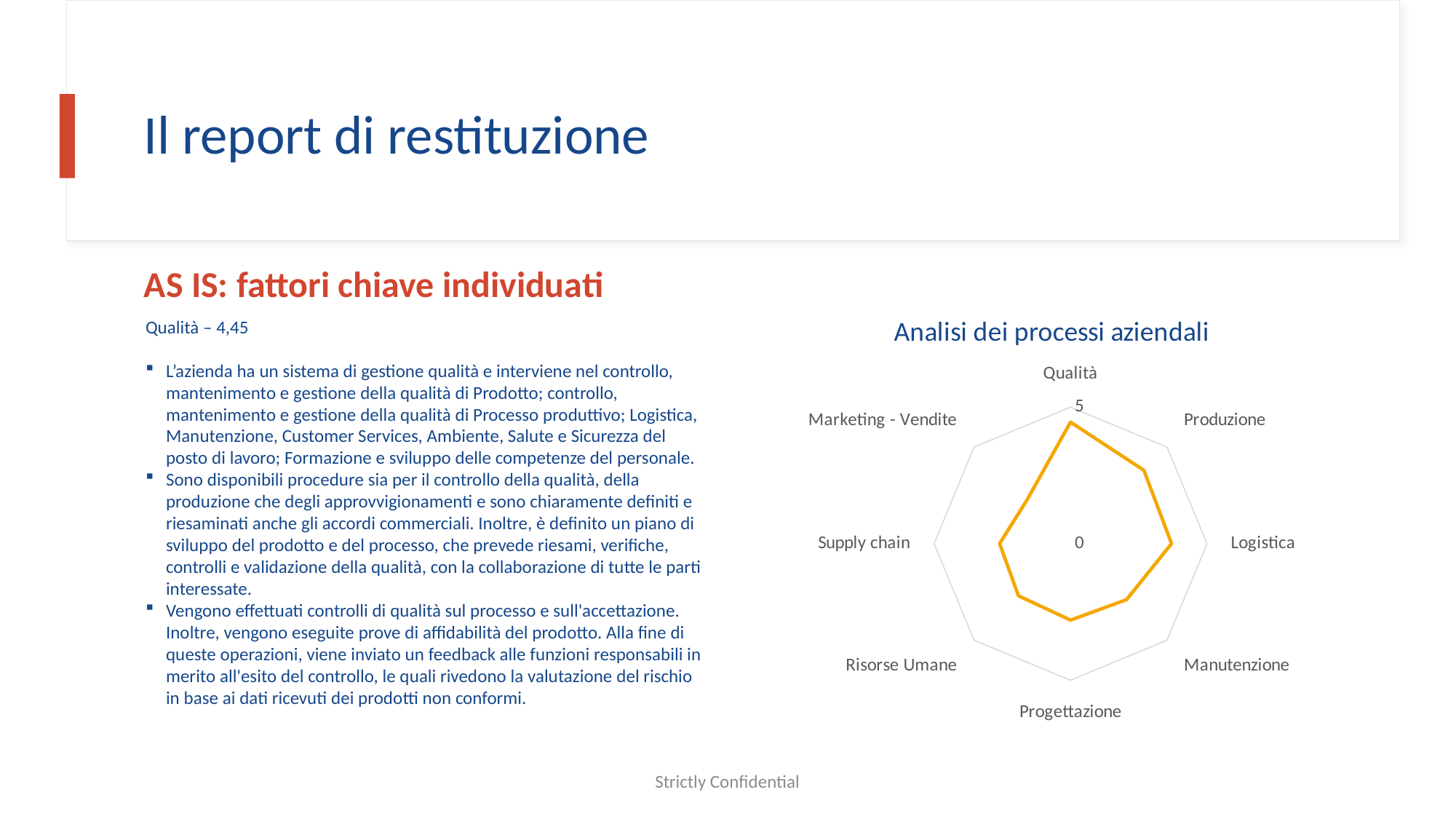
In the radar chart, which is larger: the value for Produzione or the value for Progettazione? Produzione Which category has the highest value in the radar chart? Qualità Is the value for Manutenzione in the radar chart greater or less than 5? less In the radar chart, which is larger: the value for Qualità or the value for Manutenzione? Qualità Which category is positioned at the bottom of the radar chart? Progettazione What kind of chart is shown on the slide? Radar chart What is the title of the chart on the slide? Analisi dei processi aziendali What is the maximum value shown on the radar chart's axis scale? 5 Which category is positioned at the top of the radar chart? Qualità Is the value for Supply chain in the radar chart greater or less than 5? less In the radar chart, which is larger: the value for Qualità or the value for Supply chain? Qualità How many categories (axes) does the radar chart have? 8